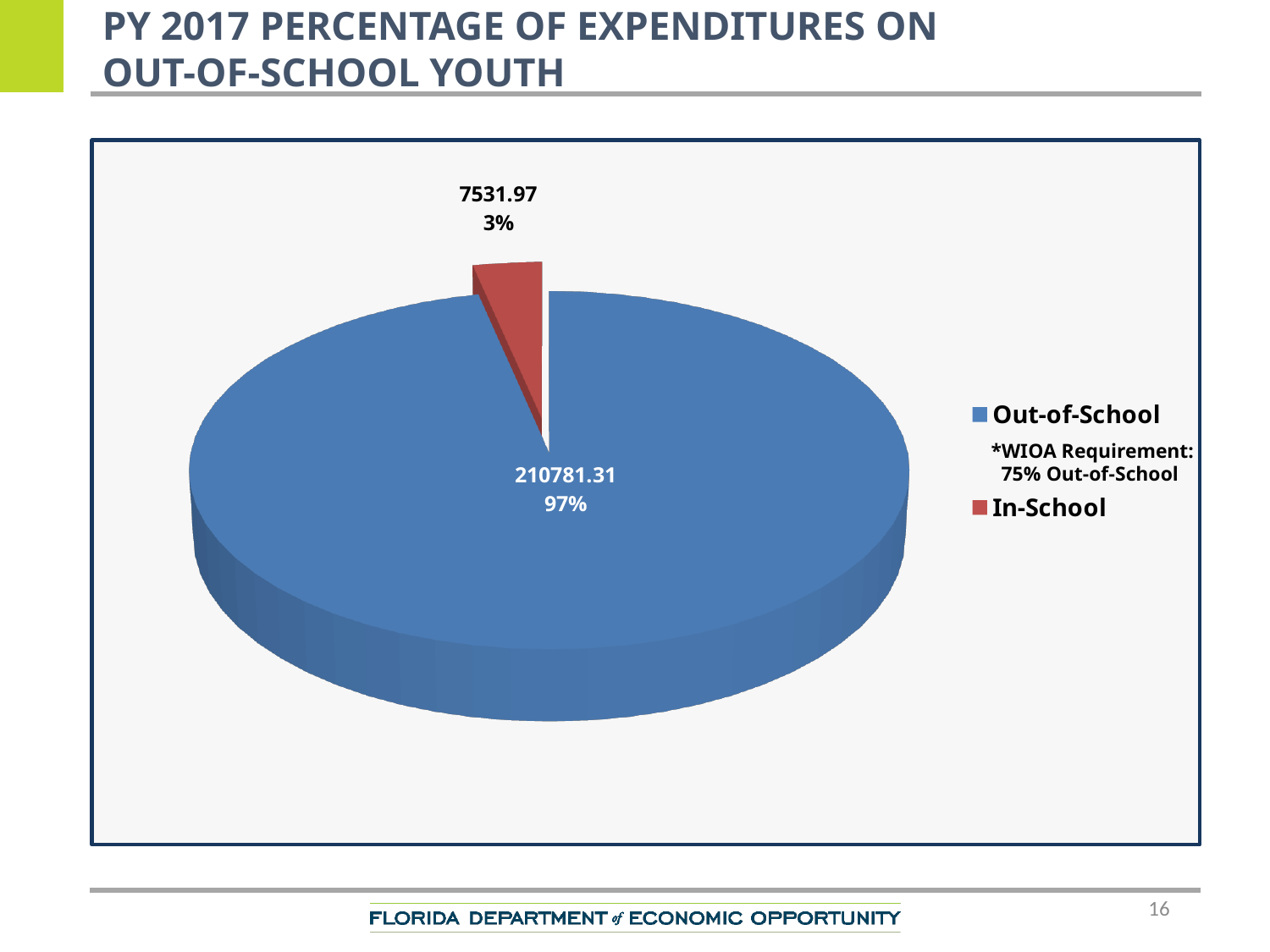
Which is larger, the value for Out-of-School or the value for In-School? Out-of-School Which category has the smallest slice? In-School What WIOA requirement is noted in the legend? 75% Out-of-School What is the value for In-School? 7531.97 What percentage share of the pie does In-School represent? 3% What percentage share of the pie does Out-of-School represent? 97% What is the difference between the Out-of-School value and the In-School value? 203249.34 What colour is the Out-of-School slice? blue What kind of chart is shown on the slide? pie chart What is the value for Out-of-School? 210781.31 How many slices does the pie chart have? 2 Which category has the largest slice? Out-of-School